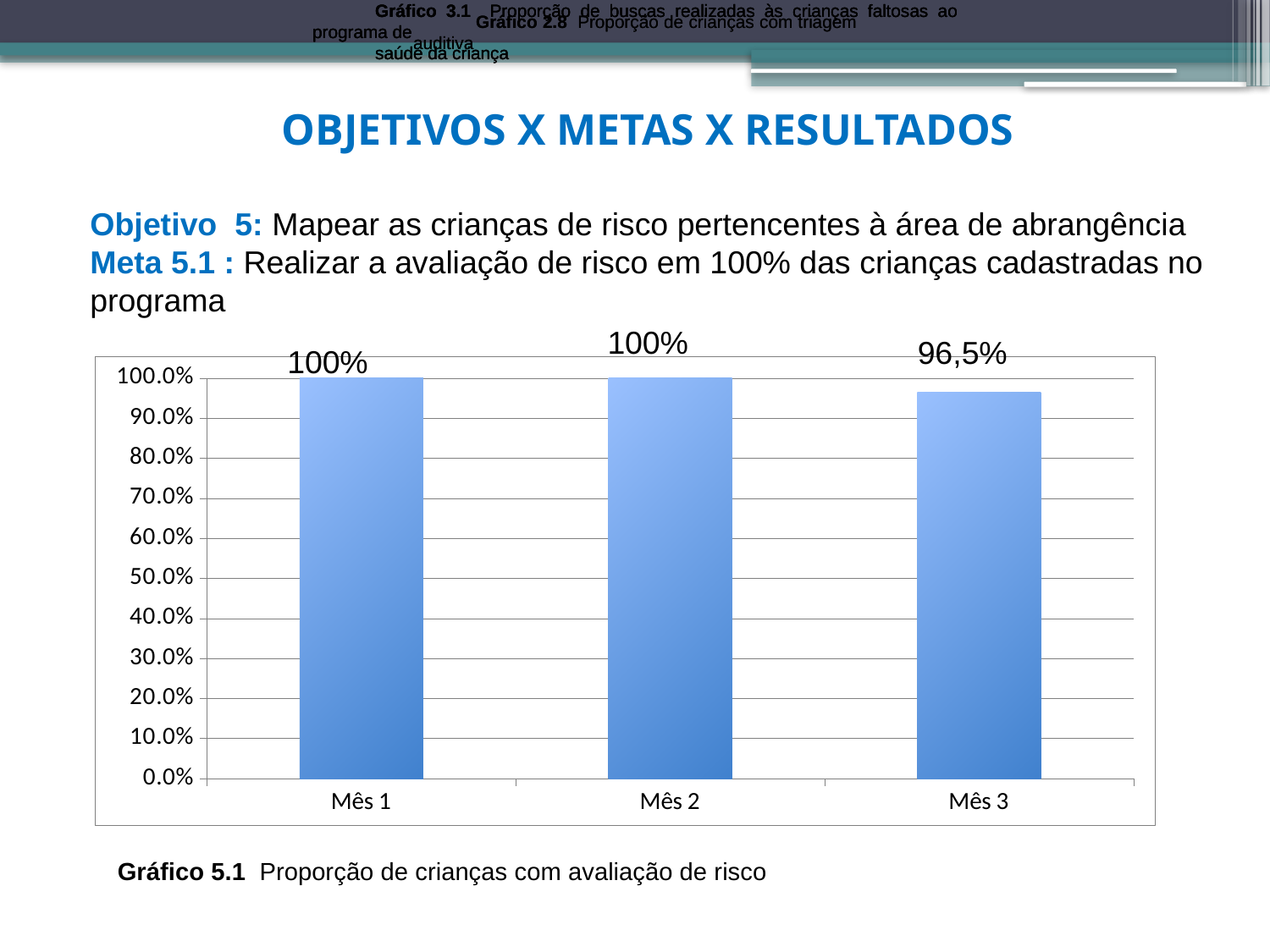
Which is larger, the value for Mês 2 or the value for Mês 3? Mês 2 What is the value for Mês 2? 100% What is the value for Mês 1? 100% Is the value for Mês 3 greater or less than 90.0%? greater What is the value for Mês 3? 96,5% What is the caption of the chart shown below it? Gráfico 5.1 Proporção de crianças com avaliação de risco What kind of chart is shown on the slide? bar chart How many categories are shown on the x axis? 3 Which month has the lowest value? Mês 3 What is the difference between the values for Mês 1 and Mês 3? 3,5% Do the values rise or fall from Mês 2 to Mês 3? fall What is the highest value shown on the y axis? 100.0%